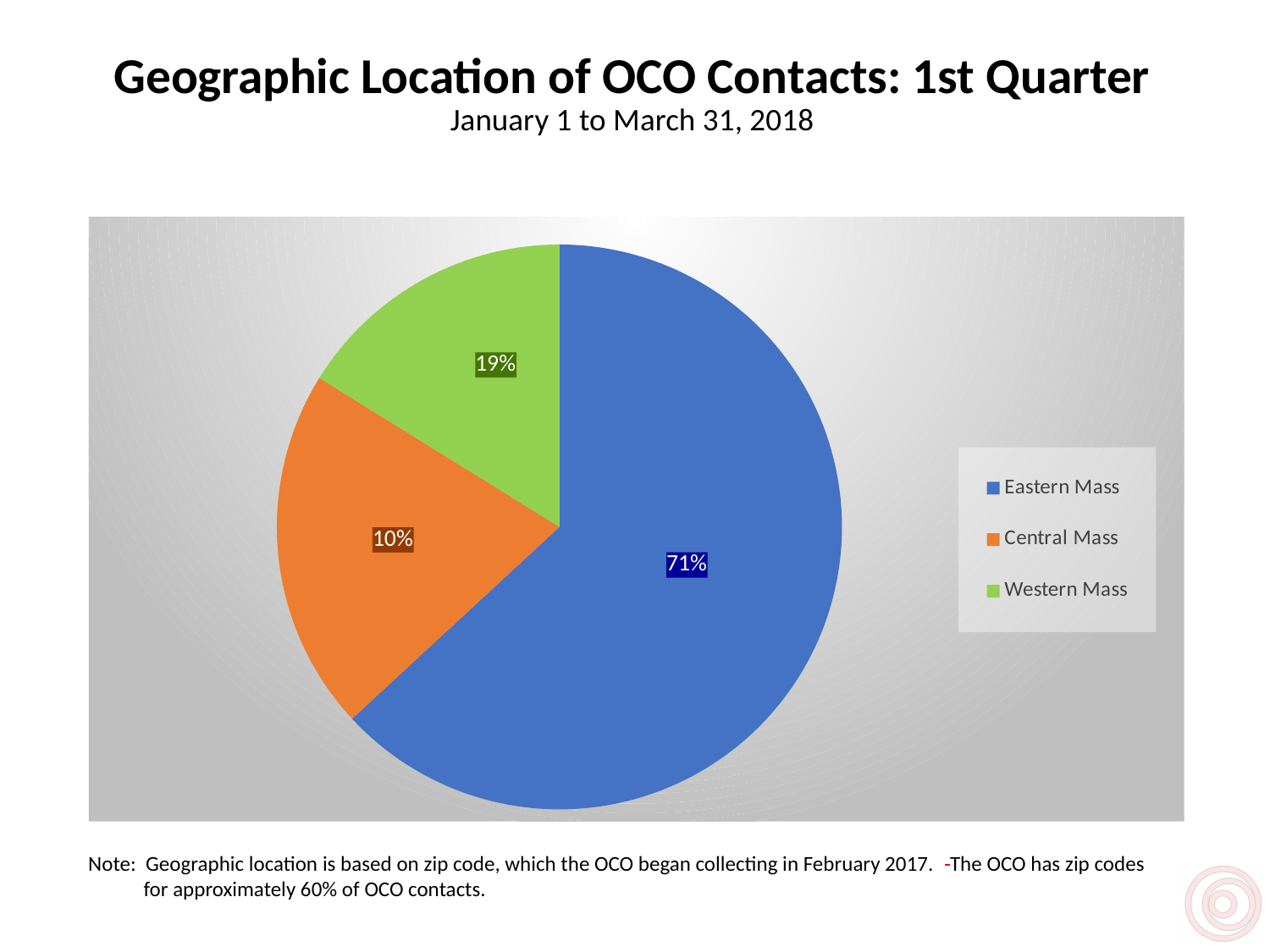
What type of chart is shown on the slide? Pie chart What percentage of OCO contacts were from Eastern Mass? 71% What date range does the chart cover, according to the subtitle? January 1 to March 31, 2018 What percentage of OCO contacts were from Central Mass? 10% How many regions are shown in the pie chart? 3 What colour represents Western Mass in the pie chart? Green What is the difference in percentage points between Eastern Mass and Western Mass? 52 Which region has the largest share of OCO contacts? Eastern Mass What is the difference in percentage points between Western Mass and Central Mass? 9 What percentage of OCO contacts were from Western Mass? 19%